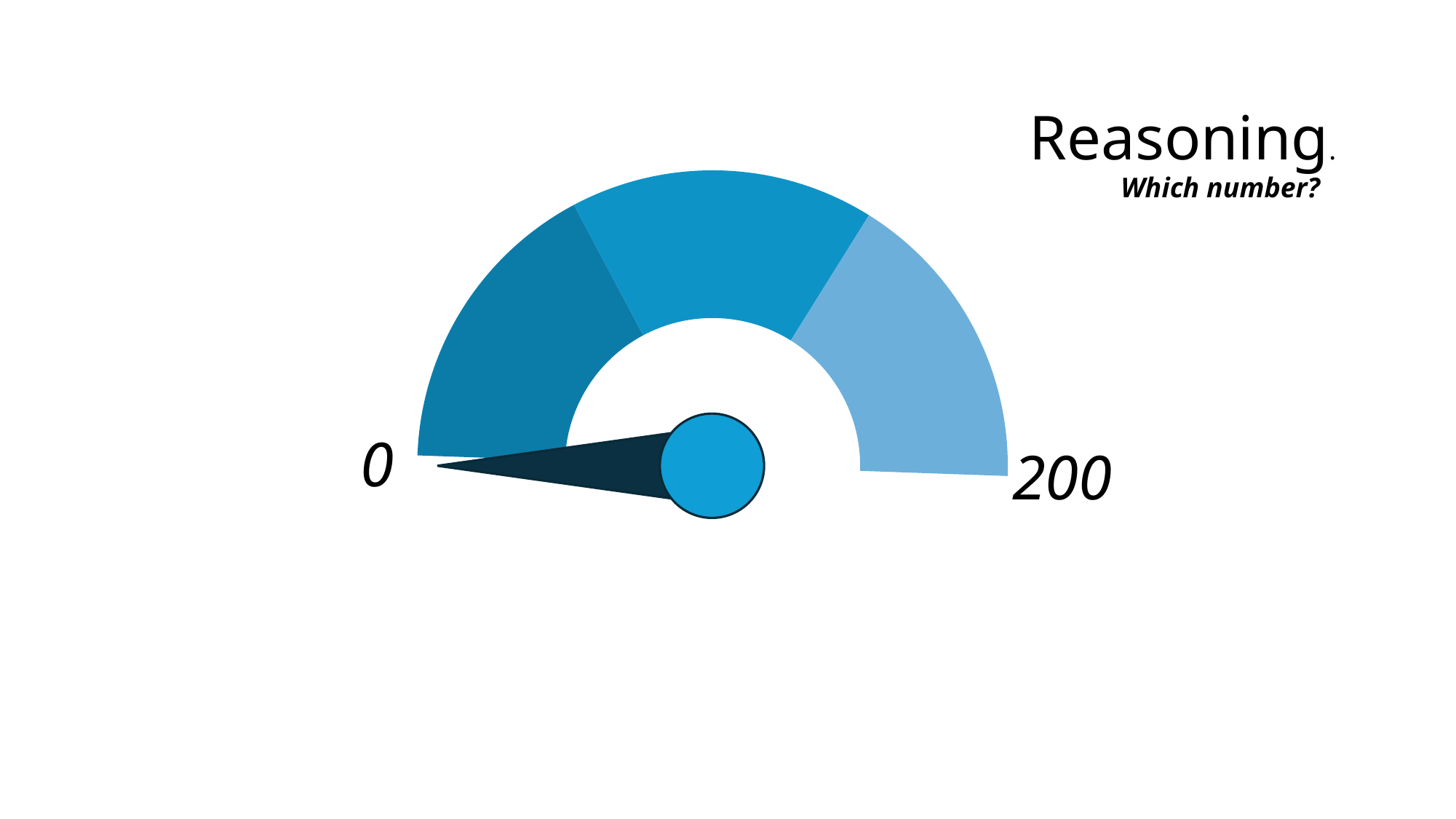
What is the lowest value labelled on the gauge scale? 0 What kind of chart is shown on the slide? gauge chart Is the needle closer to the 0 end or the 200 end of the gauge? 0 What value does the needle point to on the gauge? 0 How many coloured segments make up the gauge arc? 3 Is the value indicated by the needle greater or less than 100? less What is the highest value labelled on the gauge scale? 200